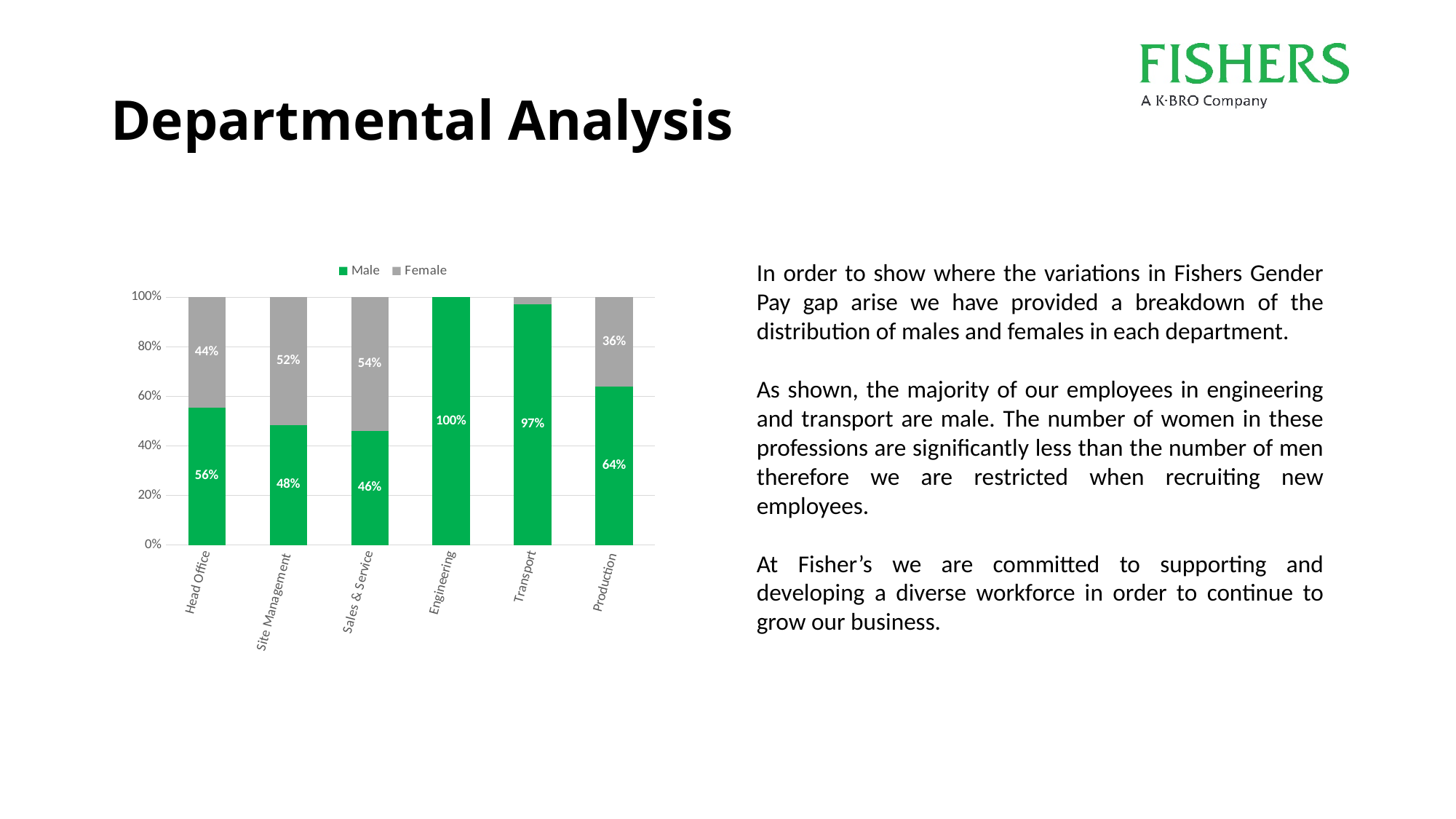
What kind of chart is shown on the slide? Stacked bar chart Which colour represents the Female series? Grey Which is larger, the Female percentage for Head Office or the Female percentage for Sales & Service? Sales & Service What is the difference between the Male percentages for Production and Site Management? 16% How many departments are shown on the x axis? 6 Which department has the lowest Male percentage? Sales & Service What is the Female percentage for Production? 36% How many series does the legend list? 2 What is the Female percentage for Site Management? 52% Which department has the highest Male percentage? Engineering What is the Male percentage for Transport? 97% What is the Male percentage for Head Office? 56%